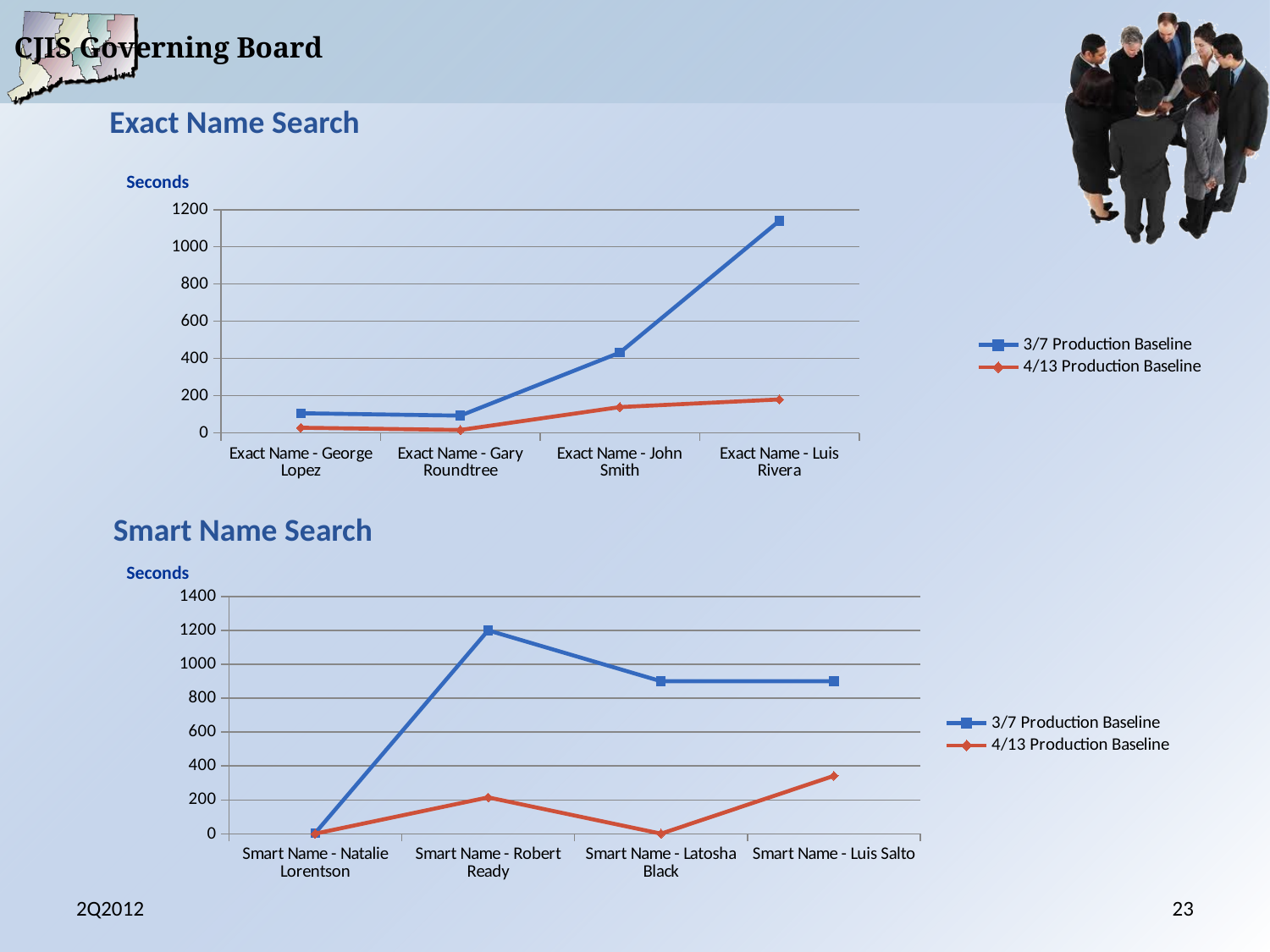
How many categories are shown on the x axis of the Smart Name Search chart? 4 How many series does the legend of the Exact Name Search chart list? 2 In the Exact Name Search chart, does the 3/7 Production Baseline series rise or fall from Exact Name - Gary Roundtree to Exact Name - Luis Rivera? rise In the Exact Name Search chart, which category has the highest value for the 3/7 Production Baseline series? Exact Name - Luis Rivera In the Exact Name Search chart, for Exact Name - Luis Rivera, which series has the larger value: 3/7 Production Baseline or 4/13 Production Baseline? 3/7 Production Baseline In the Exact Name Search chart, is the 3/7 Production Baseline value for Exact Name - Luis Rivera greater or less than 1000? greater In the Smart Name Search chart, is the 3/7 Production Baseline value for Smart Name - Robert Ready greater or less than 1000? greater In the Smart Name Search chart, which category has the highest value for the 3/7 Production Baseline series? Smart Name - Robert Ready In the Exact Name Search chart, is the 3/7 Production Baseline value for Exact Name - John Smith greater or less than 200? greater What kind of chart is the Exact Name Search chart? line chart In the Smart Name Search chart, which category has the highest value for the 4/13 Production Baseline series? Smart Name - Luis Salto